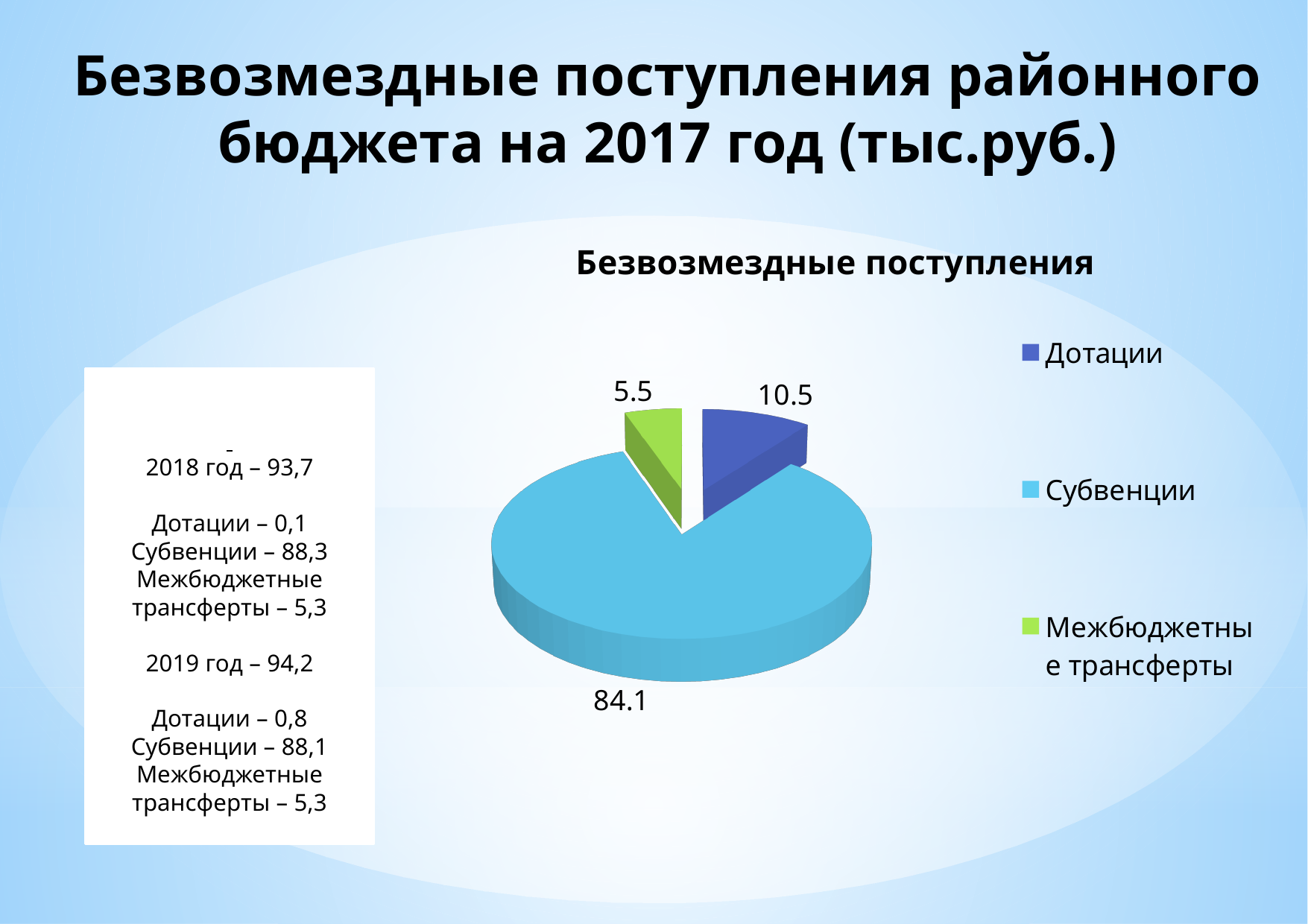
What is the difference between the values for Дотации and Межбюджетные трансферты? 5.0 What is the value shown for Дотации? 10.5 What type of chart is shown on the slide? Pie chart Which category has the largest slice of the pie? Субвенции What is the title of the chart? Безвозмездные поступления Which category has the smallest slice of the pie? Межбюджетные трансферты What is the difference between the values for Субвенции and Дотации? 73.6 What is the value shown for Субвенции? 84.1 Which is larger, the value for Дотации or the value for Межбюджетные трансферты? Дотации What colour is the slice for Субвенции? Light blue How many slices does the pie chart have? 3 What is the value shown for Межбюджетные трансферты? 5.5